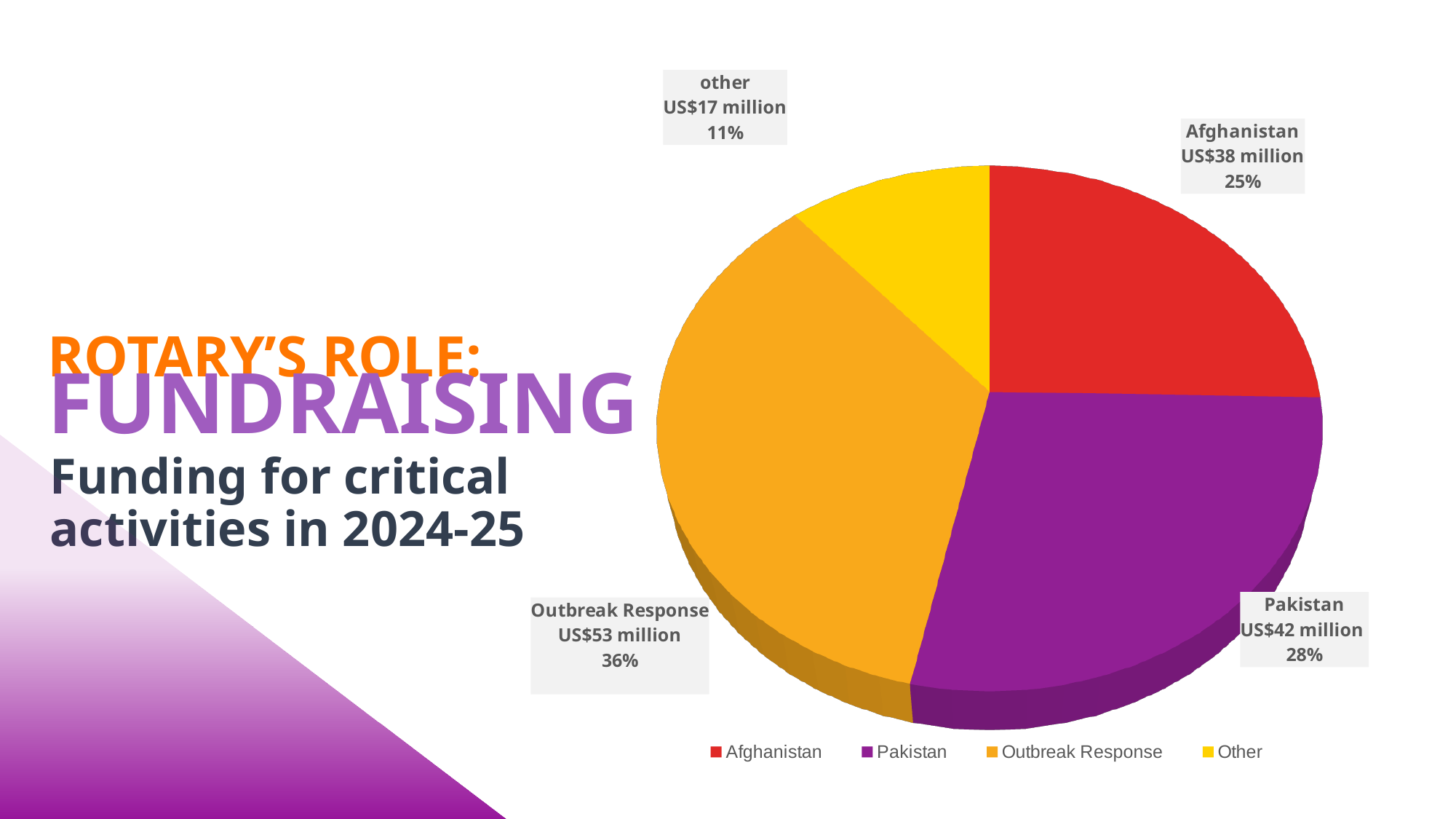
What is the funding amount for Pakistan? US$42 million How many categories are shown in the pie chart? 4 Which receives more funding, Pakistan or Afghanistan? Pakistan What is the funding amount for Outbreak Response? US$53 million What is the funding amount for Afghanistan? US$38 million What is the difference in funding between Pakistan and Afghanistan? US$4 million Which category receives the smallest amount of funding? other Which category receives the largest amount of funding? Outbreak Response What type of chart is shown on the slide? Pie chart What is the funding amount for the 'other' category? US$17 million What share of the pie does Outbreak Response represent? 36% What share of the pie does Afghanistan represent? 25%